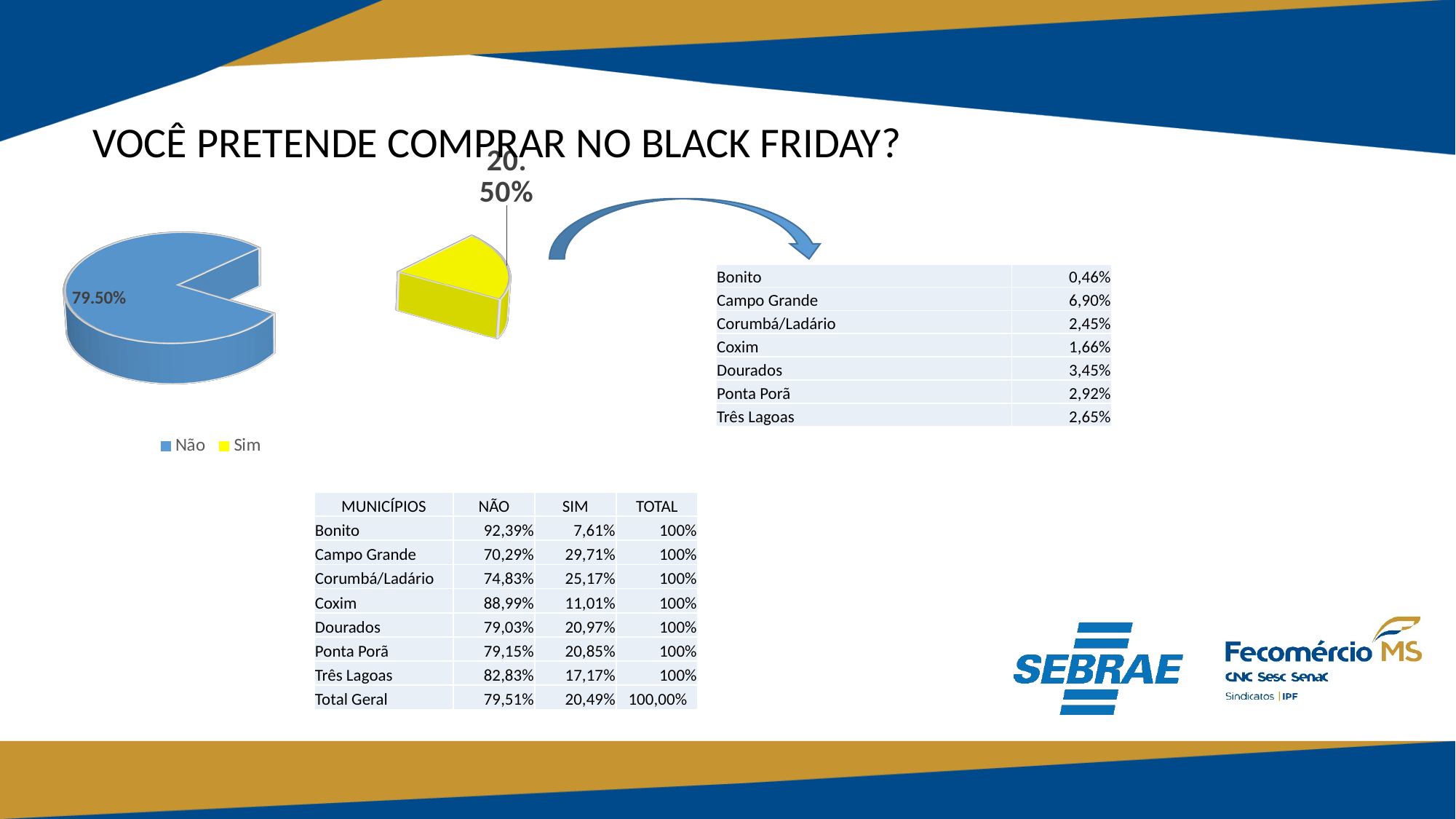
What share of the pie does the "Sim" slice represent? 20.50% Which category has the largest slice in the pie chart? Não By how many percentage points does the "Não" slice exceed the "Sim" slice in the pie chart? 59.00 percentage points What is the value shown for the "Sim" slice of the pie chart? 20.50% What kind of chart is shown on the slide? Pie chart How many slices does the pie chart have? 2 What colour is the "Sim" slice in the pie chart? Yellow Which is larger in the pie chart, the "Não" slice or the "Sim" slice? Não What is the title of the slide containing the pie chart? VOCÊ PRETENDE COMPRAR NO BLACK FRIDAY? Which category has the smallest slice in the pie chart? Sim How many entries does the pie chart's legend list? 2 What is the value shown for the "Não" slice of the pie chart? 79.50%